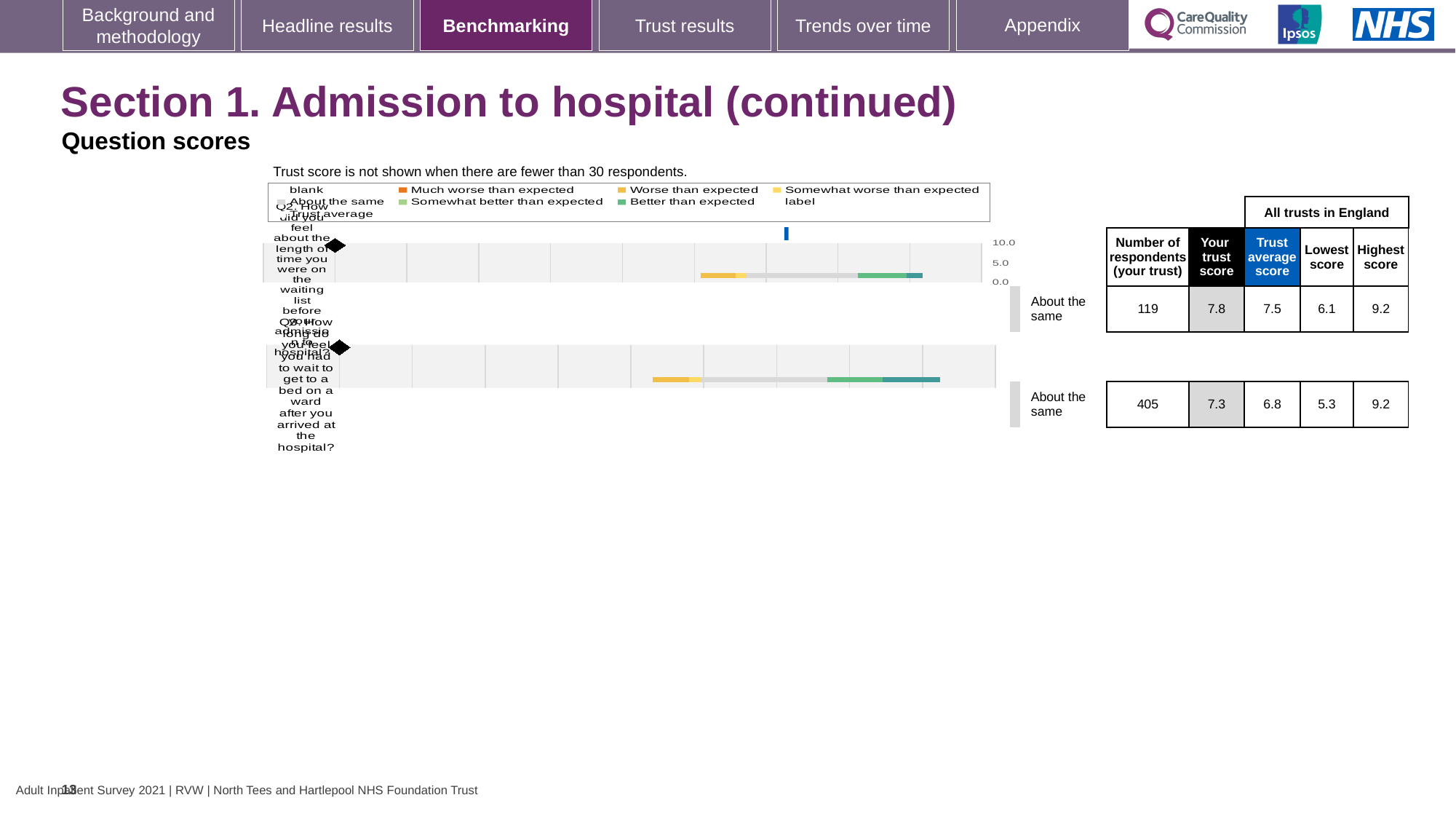
How many respondents from the trust answered Q2? 119 How many respondents from the trust answered Q3? 405 What is the lowest score across all trusts in England for Q3? 5.3 How many questions are shown in the question scores charts on this slide? 2 What is the 'Your trust score' for Q3 (how long did you feel you had to wait to get to a bed on a ward)? 7.3 What is the highest score across all trusts in England for Q2? 9.2 What is the trust average score across all trusts in England for Q2? 7.5 Is the trust's score for Q3 greater or less than 5.0 on the chart axis? greater What is the 'Your trust score' for Q2 (how did you feel about the length of time you were on the waiting list before admission)? 7.8 Which question had more respondents from the trust, Q2 or Q3? Q3 What benchmark category is shown for the trust's Q2 score? About the same By how much does the trust's score for Q3 exceed the trust average score for Q3? 0.5